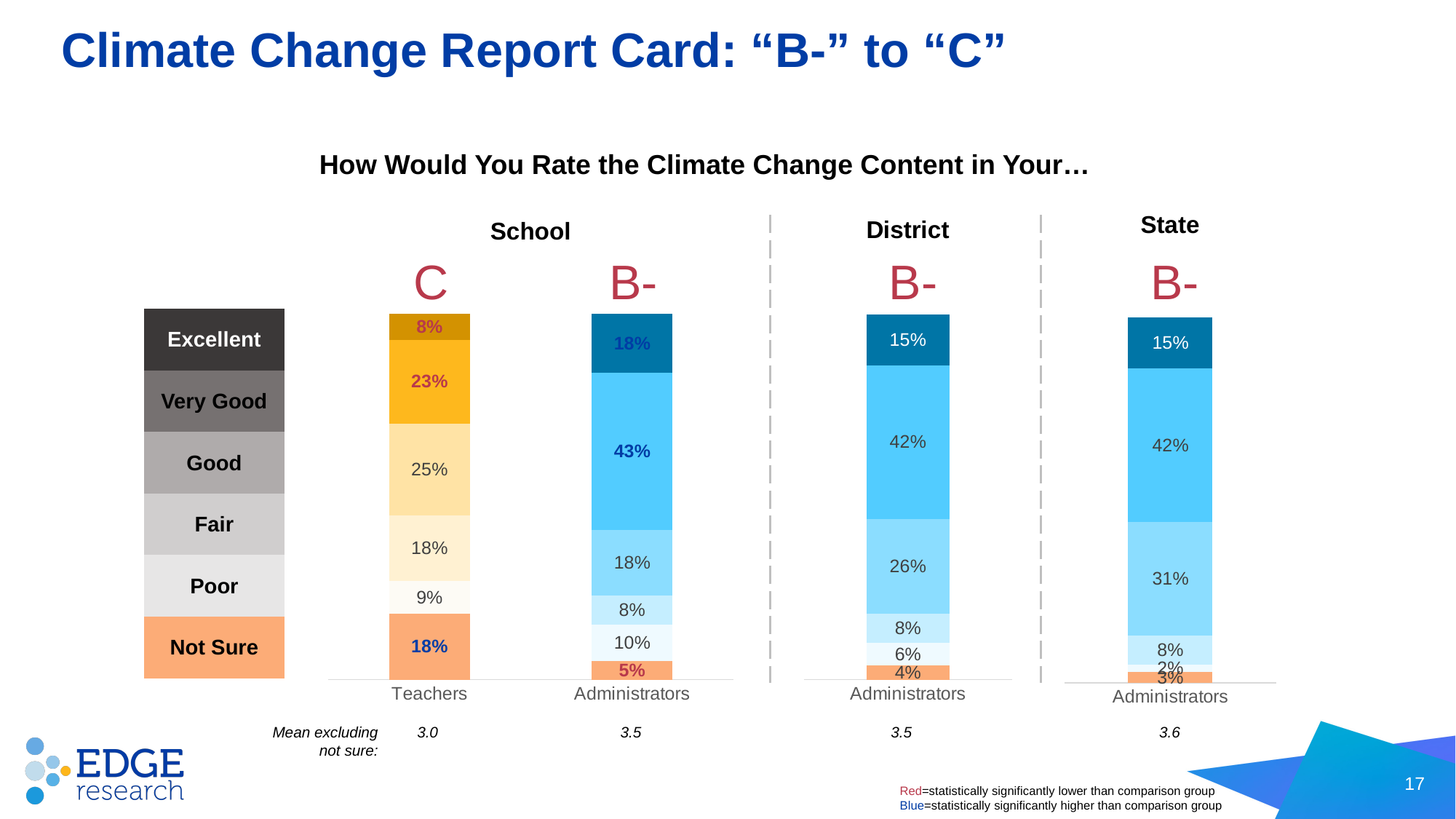
In the School chart, what percentage of Administrators rated the climate change content as Very Good? 43% In the School chart, what is the difference between the Excellent share for Administrators and the Excellent share for Teachers? 10% In the State chart, what percentage of Administrators answered Not Sure? 3% In the School chart, which rating category has the largest share among Teachers? Good What is the mean excluding not sure for State Administrators? 3.6 In the State chart, which rating category has the smallest share among Administrators? Poor In the School chart, what percentage of Teachers rated the climate change content as Very Good? 23% How many rating categories does the legend list? 6 Which is larger: the Good share for District Administrators or the Good share for State Administrators? State Administrators What kind of chart is used to show the ratings on this slide? Stacked bar chart What letter grade is shown above the Teachers bar in the School chart? C In the District chart, what percentage of Administrators rated the climate change content as Good? 26%